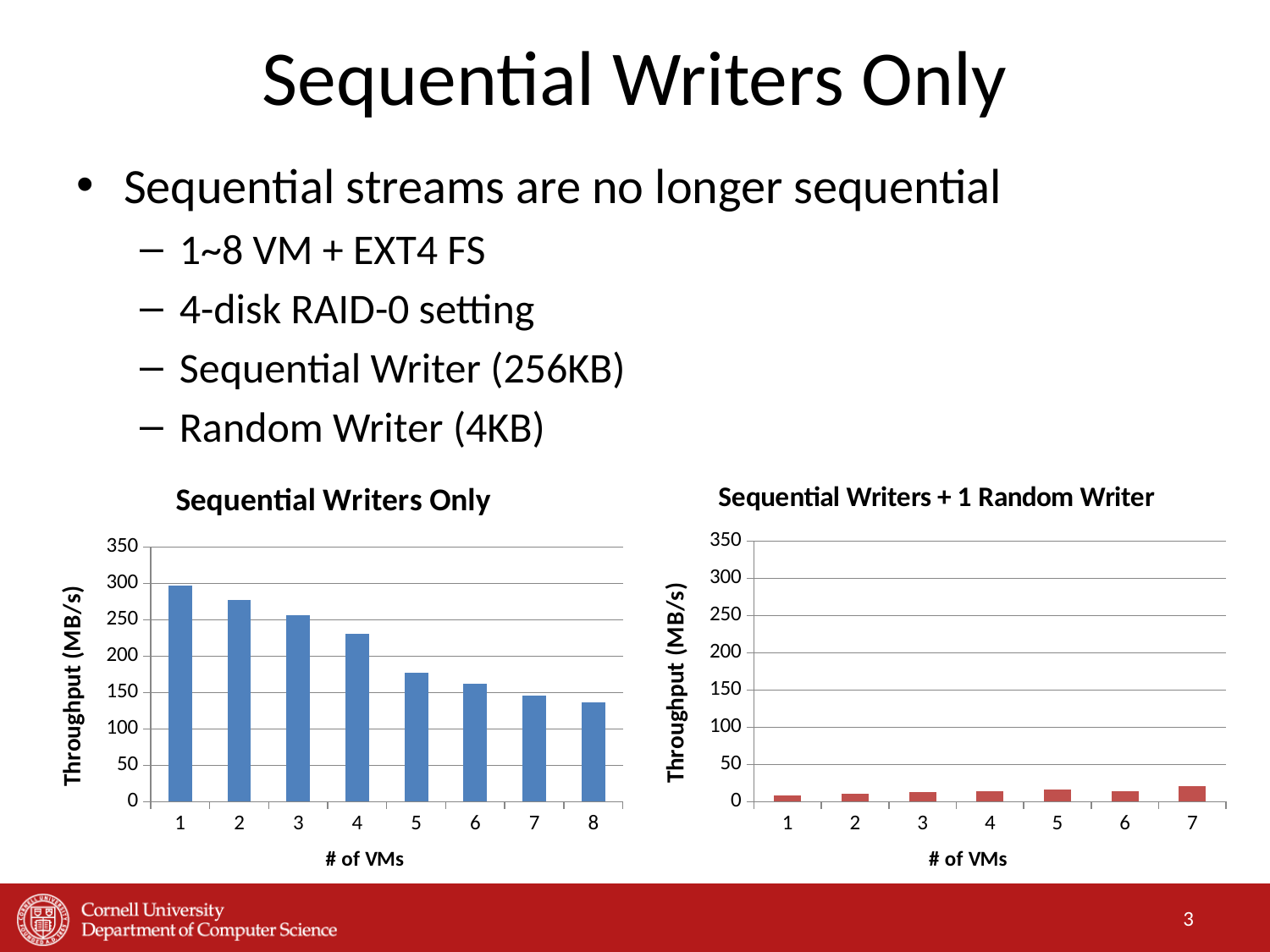
On the 'Sequential Writers Only' chart, is the throughput for 1 VM greater or less than 250? greater What type of chart is the 'Sequential Writers Only' chart? bar chart On the 'Sequential Writers Only' chart, which # of VMs has the highest throughput? 1 How many categories (# of VMs) are shown on the 'Sequential Writers + 1 Random Writer' chart? 7 What is the y-axis label on the 'Sequential Writers + 1 Random Writer' chart? Throughput (MB/s) On the 'Sequential Writers Only' chart, is the throughput for 5 VMs greater or less than 200? less On the 'Sequential Writers Only' chart, which # of VMs has the lowest throughput? 8 What is the x-axis label on the 'Sequential Writers Only' chart? # of VMs How many categories (# of VMs) are shown on the 'Sequential Writers Only' chart? 8 On the 'Sequential Writers Only' chart, which has higher throughput: 2 VMs or 6 VMs? 2 VMs On the 'Sequential Writers + 1 Random Writer' chart, is the throughput for 4 VMs greater or less than 50? less On the 'Sequential Writers Only' chart, does throughput rise or fall as the number of VMs increases? fall